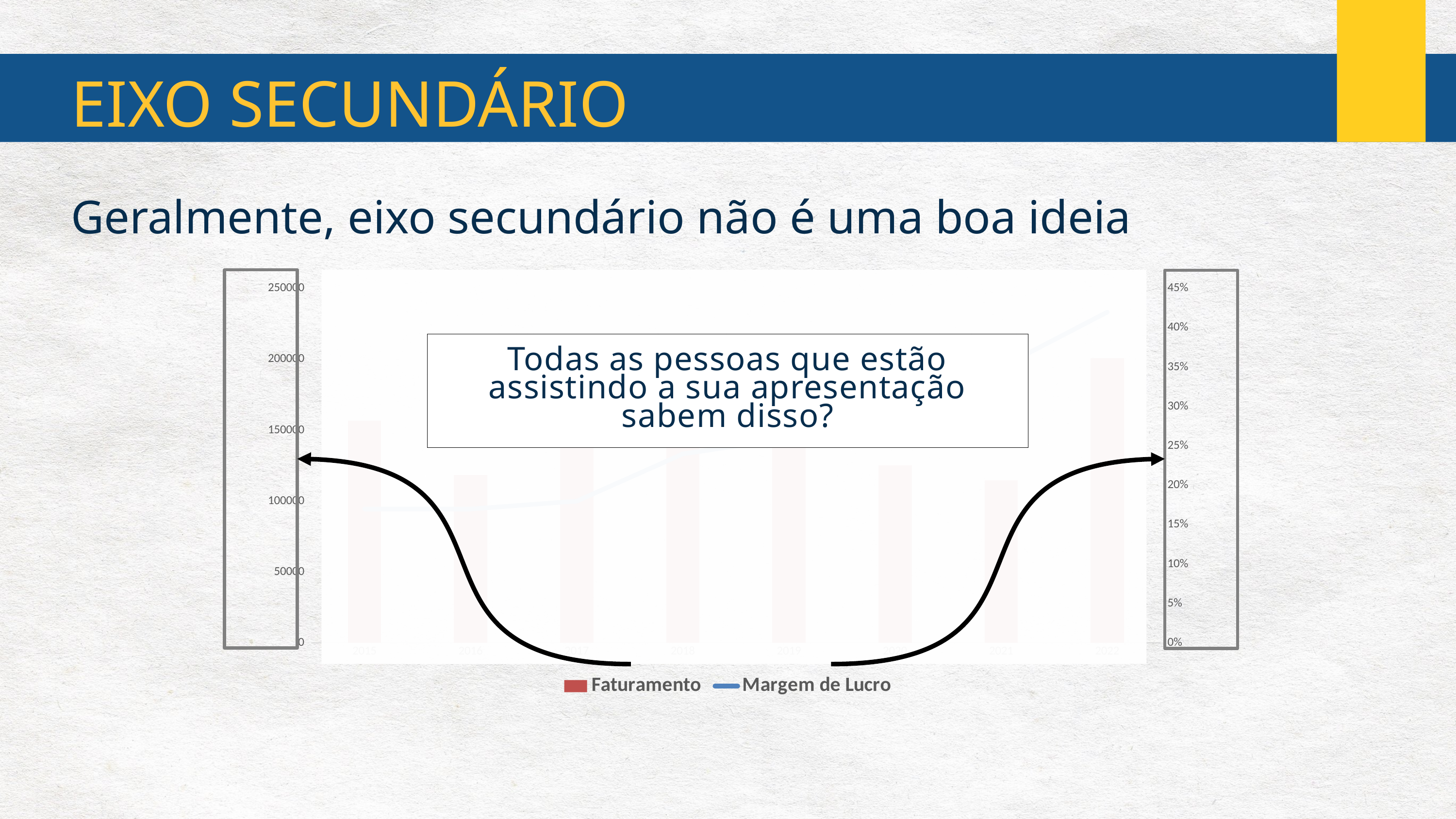
What are the two series named in the chart legend? Faturamento and Margem de Lucro How many series does the chart legend list? 2 Is the Faturamento value for 2016 greater or less than 100000? greater Is the Faturamento value for 2022 greater or less than 150000? greater What is the highest tick value shown on the left (primary) vertical axis? 250000 Does the Margem de Lucro line generally rise or fall from 2015 to 2022? rise Which series is plotted as bars in the chart? Faturamento Which year has the larger Faturamento bar, 2015 or 2016? 2015 What is the highest tick value shown on the right (secondary) vertical axis? 45% How many years (bars) are plotted on the chart's x axis? 8 Is the Faturamento value for 2015 greater or less than 100000? greater